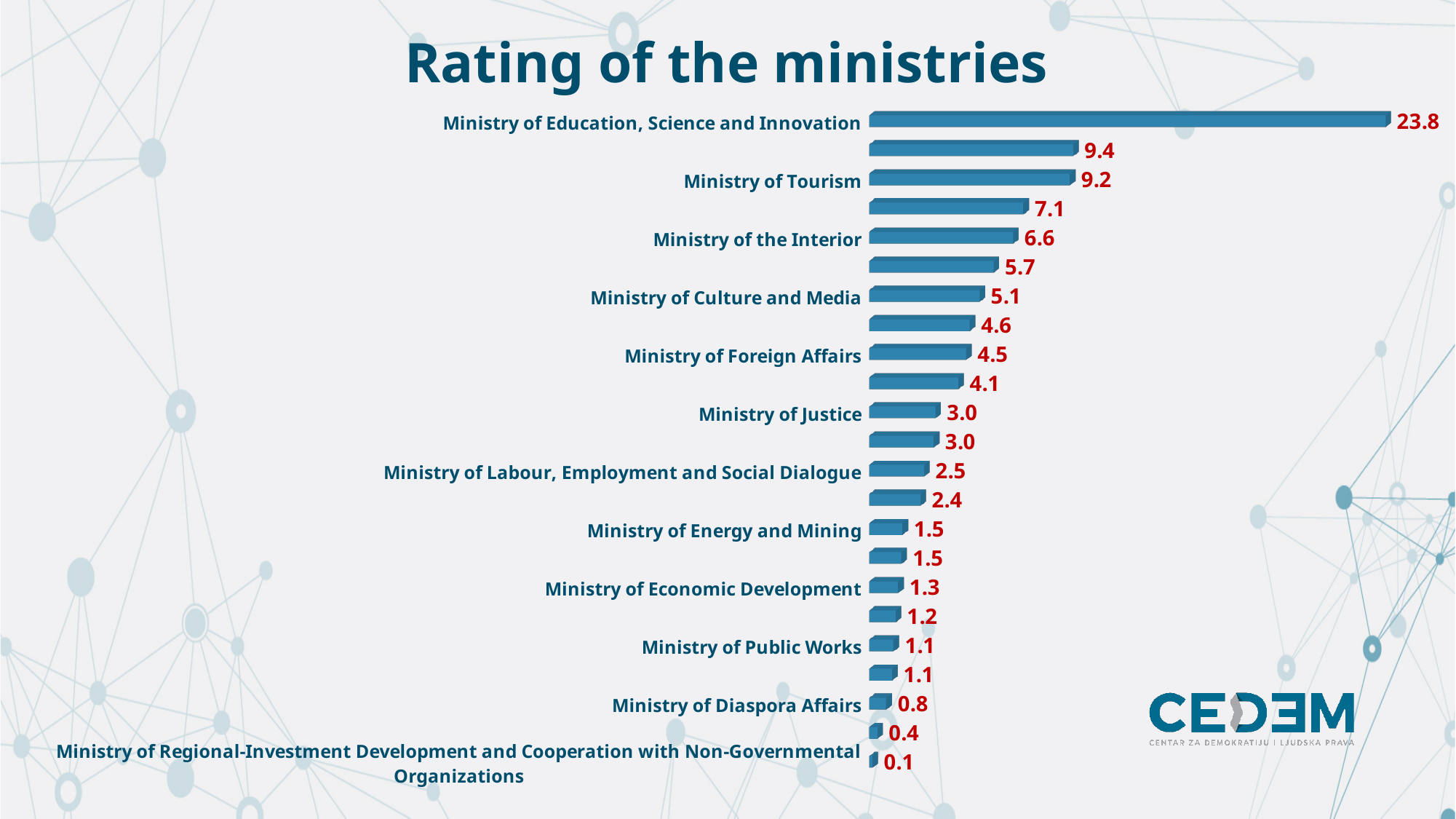
What is the rating for the Ministry of Foreign Affairs? 4.5 What is the difference between the ratings of the Ministry of Education, Science and Innovation and the Ministry of Tourism? 14.6 Which ministry has the highest rating? Ministry of Education, Science and Innovation Which has a higher rating, the Ministry of Culture and Media or the Ministry of Justice? Ministry of Culture and Media What is the title of the chart? Rating of the ministries How many bars are plotted in the chart? 23 What is the rating for the Ministry of Education, Science and Innovation? 23.8 What is the rating for the Ministry of the Interior? 6.6 What kind of chart is shown on the slide? Bar chart What is the rating for the Ministry of Tourism? 9.2 Which ministry has the lowest rating? Ministry of Regional-Investment Development and Cooperation with Non-Governmental Organizations What is the rating for the Ministry of Diaspora Affairs? 0.8